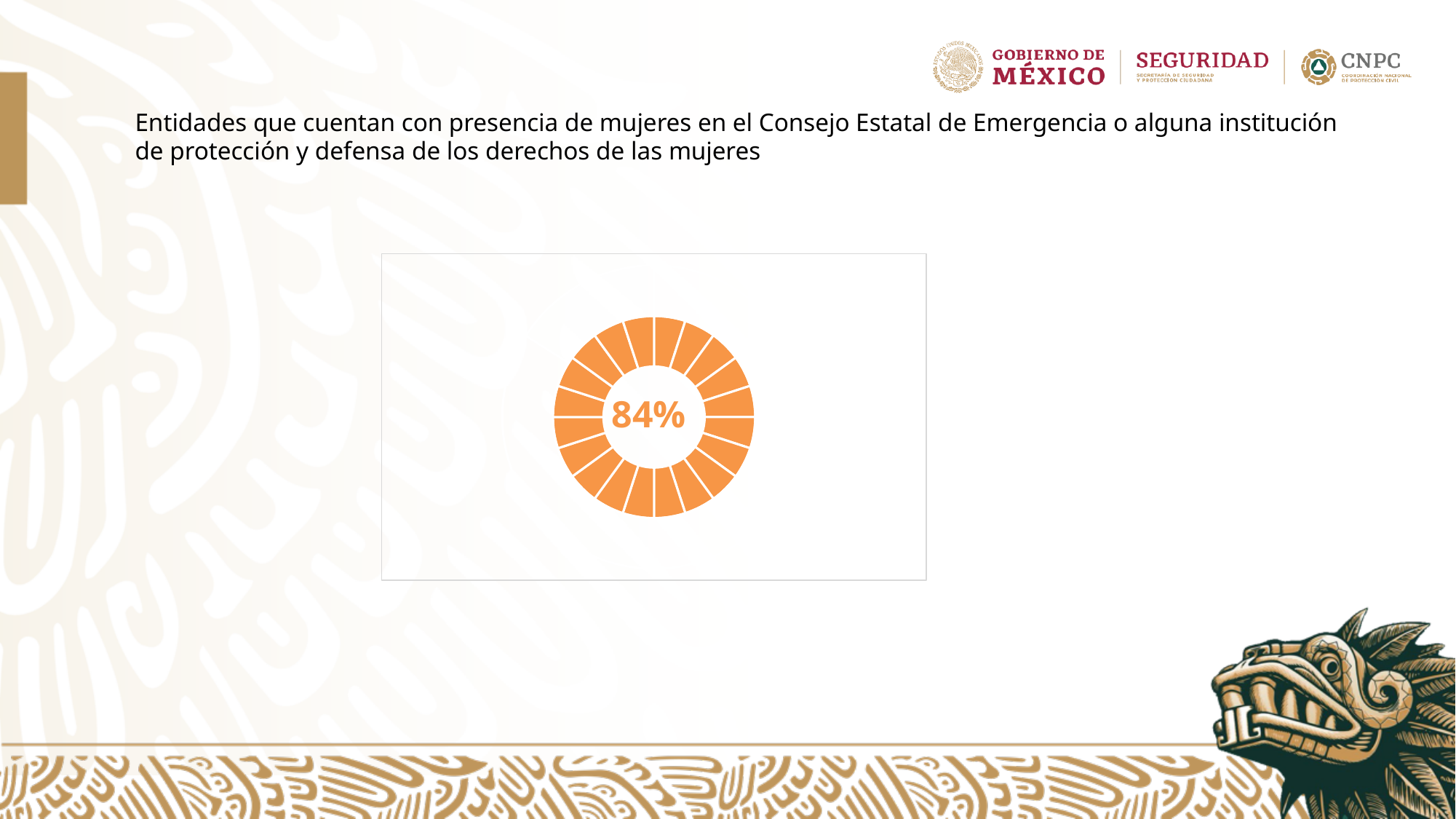
According to the slide title, what share of entities have women present in the Consejo Estatal de Emergencia or an institution for the protection and defence of women's rights? 84% Does the chart on the slide include a legend? No What percentage is displayed in the centre of the doughnut chart? 84% Is the percentage shown in the centre of the chart greater or less than 50%? greater What kind of chart is shown on the slide? Doughnut chart What colour are the segments of the doughnut chart? Orange